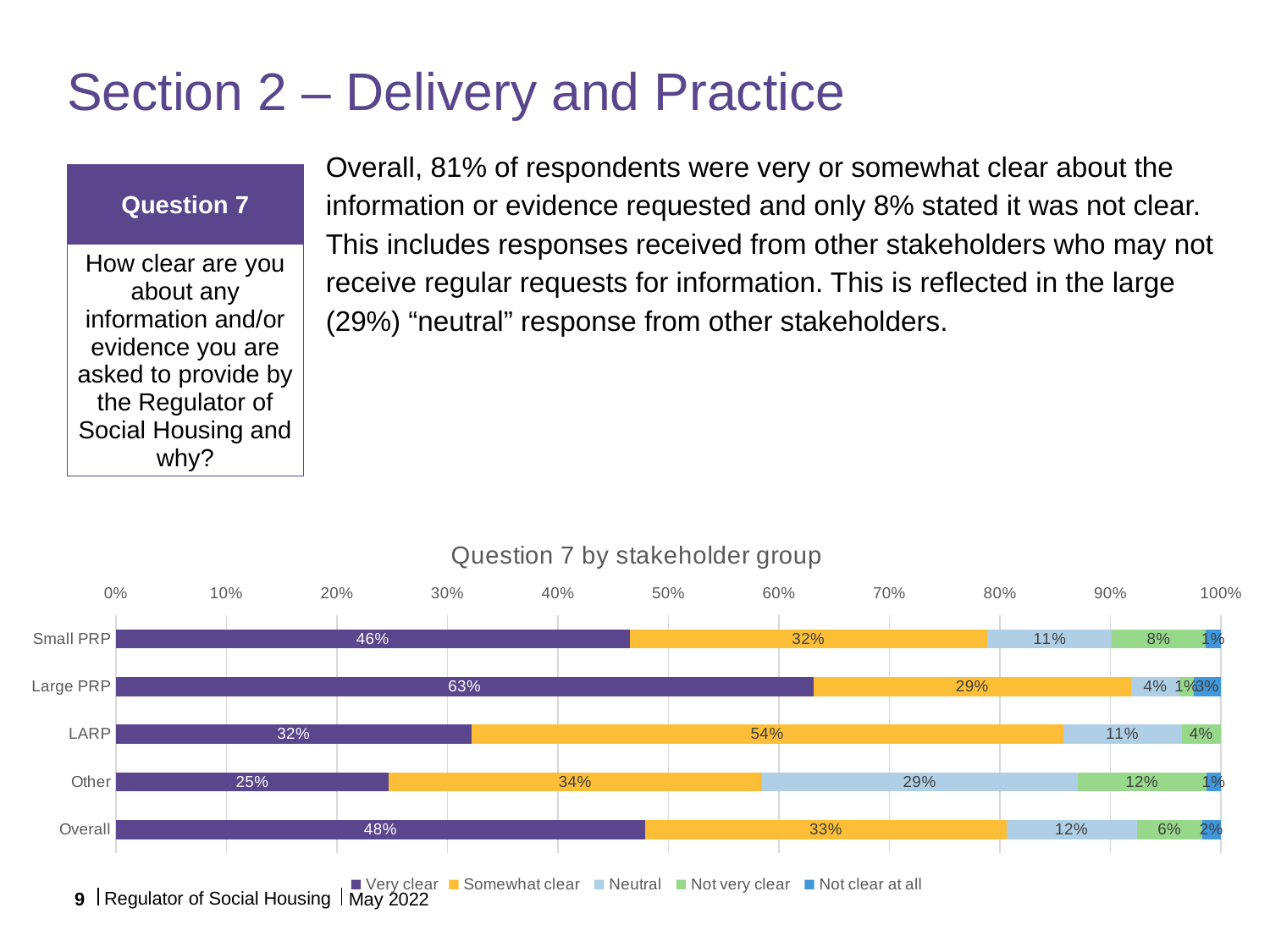
What percentage of Large PRP respondents were Very clear? 63% What is the title of the chart? Question 7 by stakeholder group Which is larger: the Somewhat clear value for LARP or for Overall? LARP How many stakeholder groups are shown on the chart? 5 Which stakeholder group has the highest Very clear percentage? Large PRP Which stakeholder group has the lowest Very clear percentage? Other What percentage of LARP respondents were Somewhat clear? 54% What is the difference between the Very clear percentages for Large PRP and Small PRP? 17% What is the Neutral value for the Other stakeholder group? 29% What is the Not very clear value for Small PRP? 8% What type of chart is shown on the slide? Stacked bar chart How many series does the chart legend list? 5